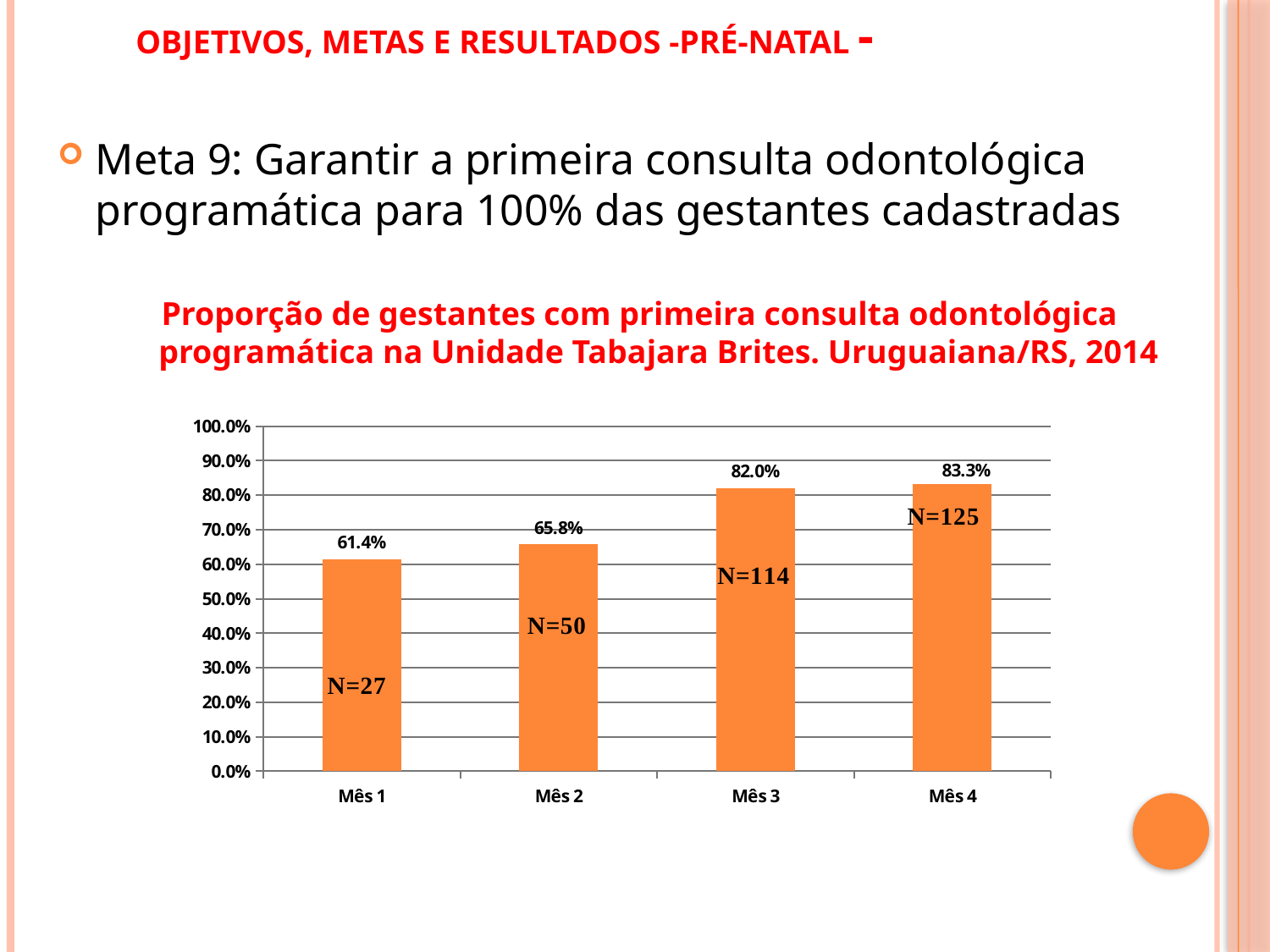
What is the value for Mês 3? 82.0% Is the value for Mês 2 greater or less than 70.0%? less What is the N value shown inside the bar for Mês 2? N=50 What kind of chart is shown on the slide? bar chart How many months are shown on the x axis? 4 What is the difference between the values for Mês 3 and Mês 1? 20.6% Do the values rise or fall from Mês 1 to Mês 4? rise What is the value for Mês 1? 61.4% Which month has the highest proportion? Mês 4 Which month has the lowest proportion? Mês 1 Which is larger, the value for Mês 2 or the value for Mês 3? Mês 3 What is the value for Mês 4? 83.3%